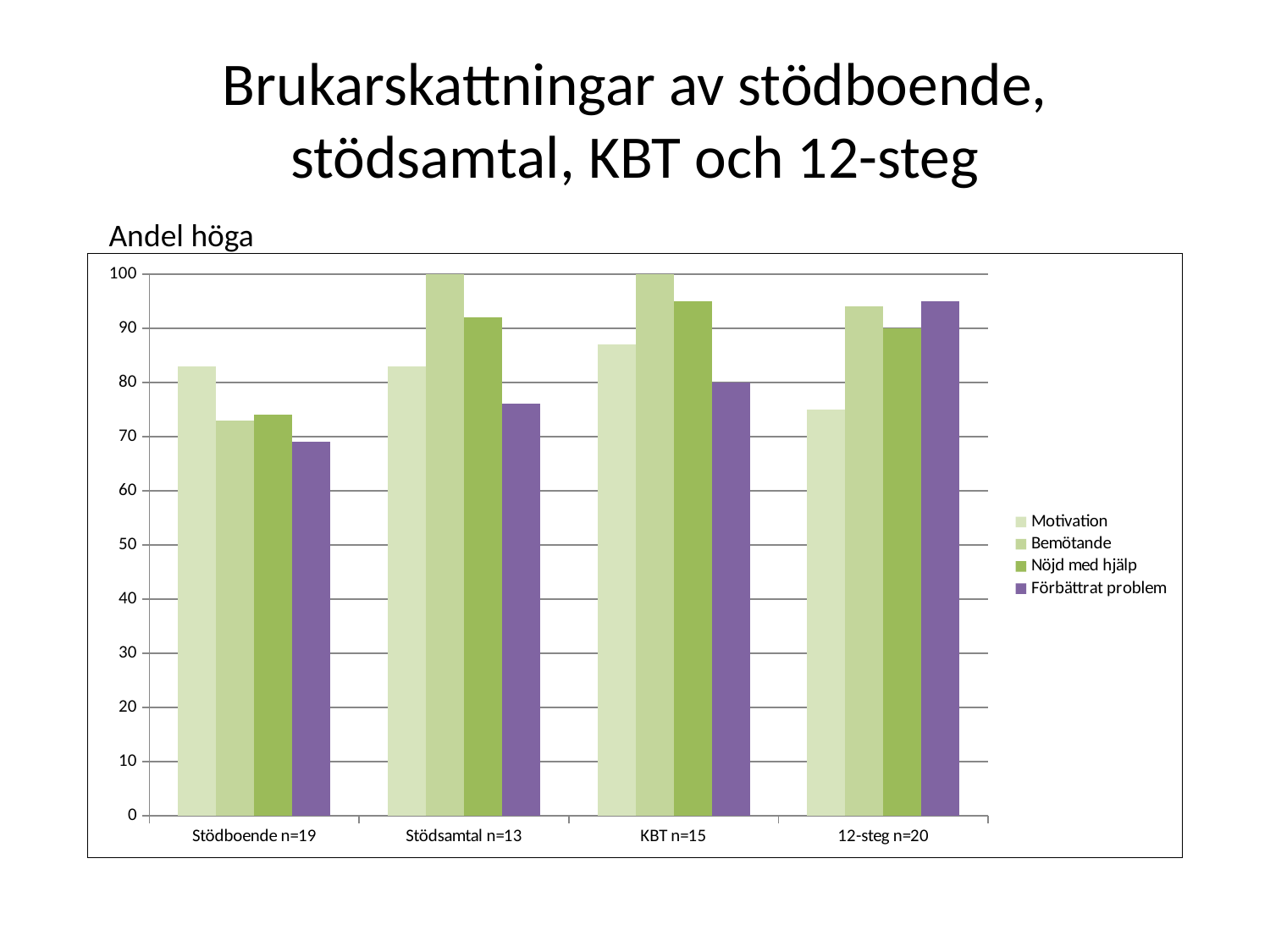
Which category has the highest Förbättrat problem value? 12-steg n=20 What is the Bemötande value for Stödsamtal n=13? 100 Which is larger for Stödboende n=19: Motivation or Bemötande? Motivation Which category has the lowest Förbättrat problem value? Stödboende n=19 What kind of chart is shown on the slide? bar chart How many categories are shown on the x axis of the chart? 4 Is the Motivation value for 12-steg n=20 greater or less than 80? less How many series does the legend list? 4 What is the Förbättrat problem value for KBT n=15? 80 What is the Bemötande value for KBT n=15? 100 What is the label shown above the chart's y axis? Andel höga